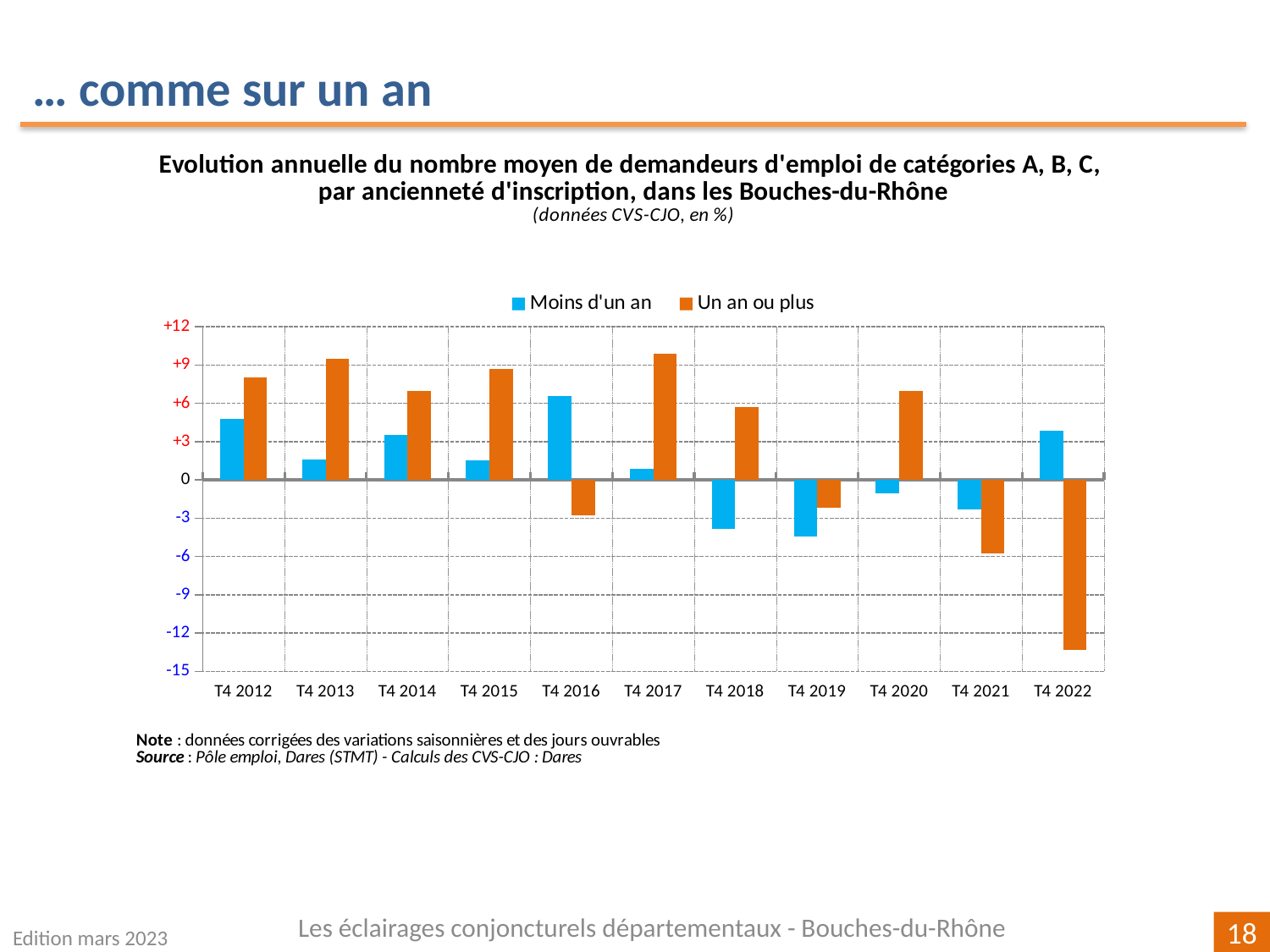
Is the value for 'Un an ou plus' in T4 2013 greater or less than 9? greater Is the value for 'Un an ou plus' in T4 2022 greater or less than -12? less In which quarter is the value for 'Moins d'un an' the highest? T4 2016 Is the value for 'Moins d'un an' in T4 2016 greater or less than 6? greater How many series does the legend list? 2 What kind of chart is shown on the slide? Bar chart Which colour represents the 'Un an ou plus' series? Orange In T4 2012, which series has the larger value, 'Moins d'un an' or 'Un an ou plus'? Un an ou plus In T4 2022, which series has the larger value, 'Moins d'un an' or 'Un an ou plus'? Moins d'un an How many quarters (categories) are shown on the x axis? 11 In which quarter is the value for 'Un an ou plus' the lowest? T4 2022